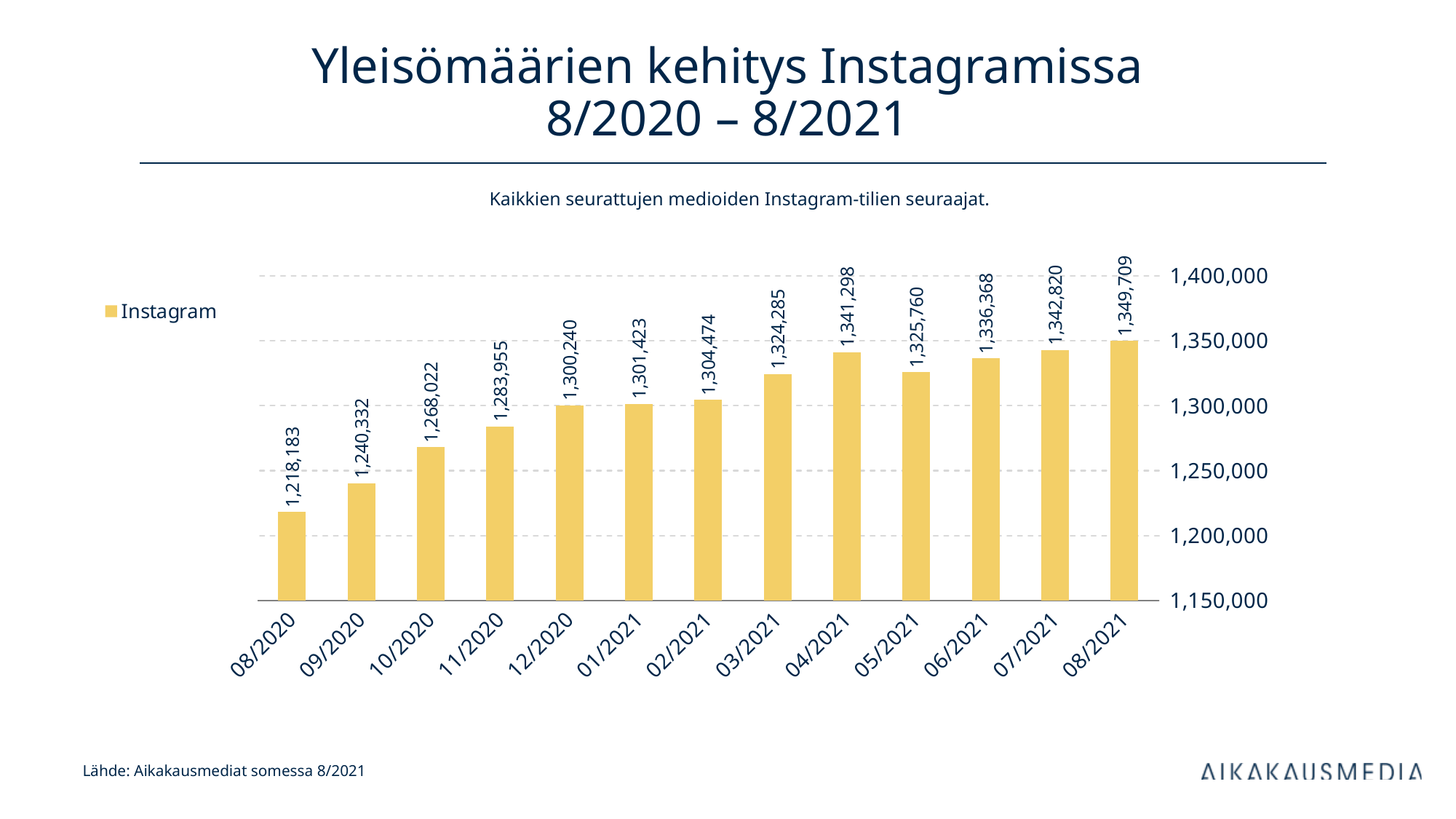
Is the value for 11/2020 greater or less than 1,300,000? less Which month has the highest value? 08/2021 What is the value for 08/2021? 1,349,709 What is the value for 03/2021? 1,324,285 What type of chart is shown on the slide? Bar chart How many series does the legend list? 1 What is the value for 08/2020? 1,218,183 Which is larger, the value for 04/2021 or the value for 05/2021? 04/2021 Which month has the lowest value? 08/2020 What is the difference between the values for 08/2021 and 08/2020? 131,526 How many months are plotted on the chart? 13 What is the name of the series shown in the legend? Instagram